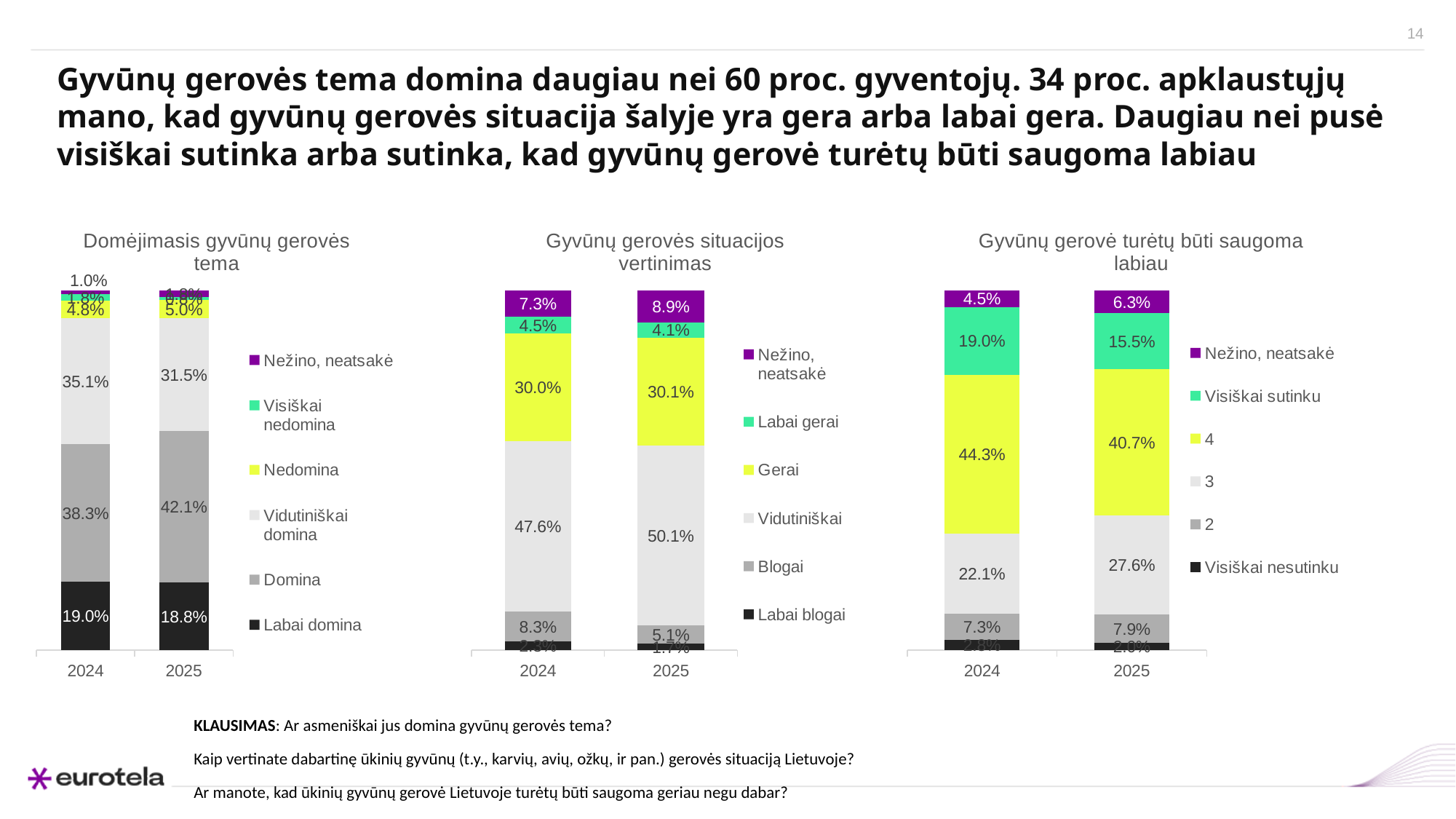
In the chart 'Gyvūnų gerovės situacijos vertinimas', what is the value for 'Vidutiniškai' in 2025? 50.1% In the chart 'Gyvūnų gerovė turėtų būti saugoma labiau', what is the value for '4' in 2024? 44.3% In the chart 'Gyvūnų gerovė turėtų būti saugoma labiau', what is the difference between the 'Visiškai sutinku' values for 2024 and 2025? 3.5% In the chart 'Domėjimasis gyvūnų gerovės tema', what is the difference between the 'Vidutiniškai domina' values for 2024 and 2025? 3.6% In the chart 'Gyvūnų gerovės situacijos vertinimas', what is the value for 'Nežino, neatsakė' in 2025? 8.9% In the chart 'Gyvūnų gerovė turėtų būti saugoma labiau', how many series does the legend list? 6 In the chart 'Gyvūnų gerovės situacijos vertinimas', which segment is the largest in the 2024 bar? Vidutiniškai In the chart 'Domėjimasis gyvūnų gerovės tema', what is the value for 'Labai domina' in 2024? 19.0% In the chart 'Domėjimasis gyvūnų gerovės tema', what is the value for 'Domina' in 2025? 42.1% In the chart 'Gyvūnų gerovės situacijos vertinimas', is the 'Blogai' value larger in 2024 or 2025? 2024 How many year categories are shown on the x axis of the chart 'Gyvūnų gerovės situacijos vertinimas'? 2 What type of chart is 'Domėjimasis gyvūnų gerovės tema'? Stacked bar chart